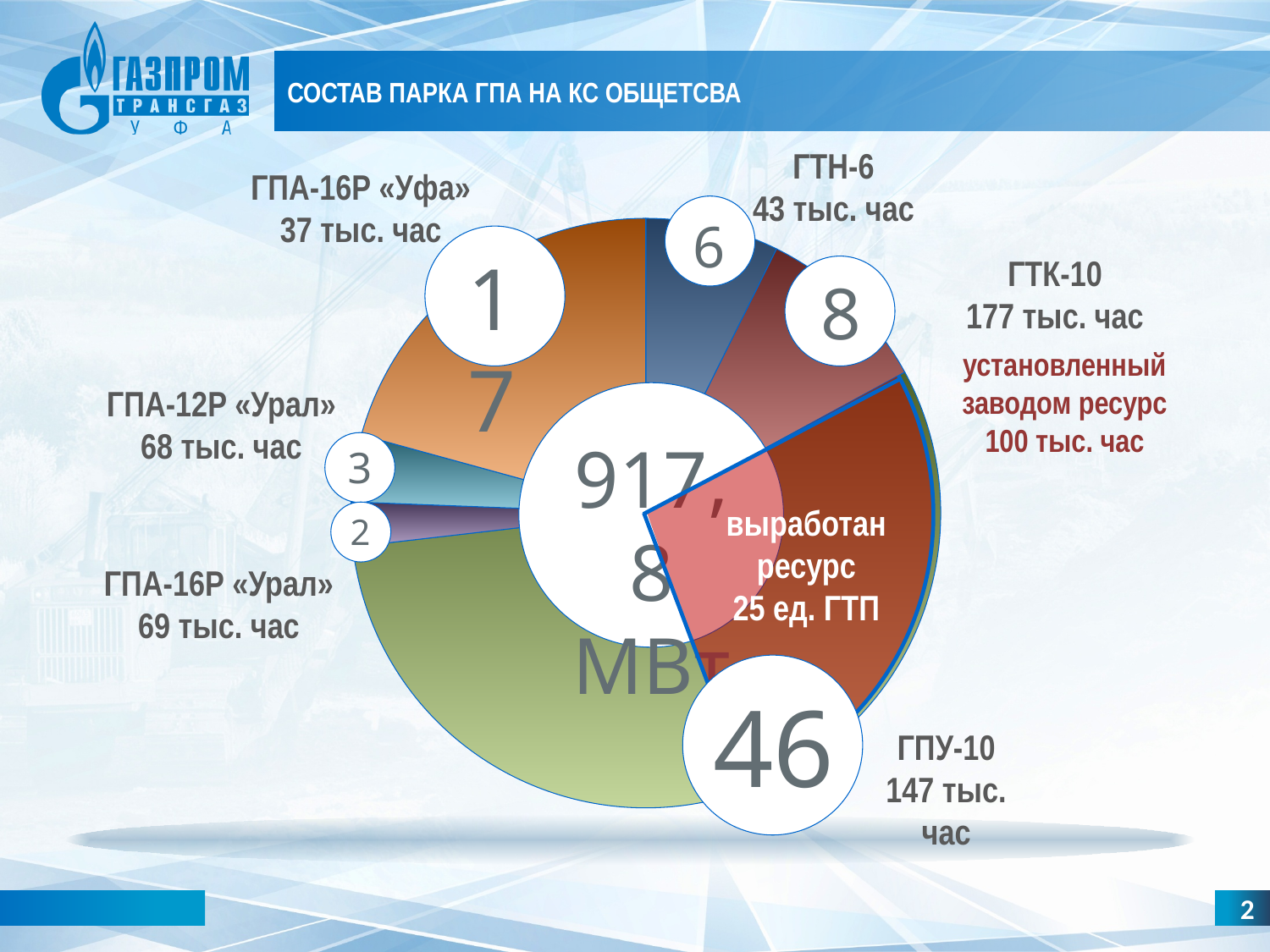
What is the title of the chart on the slide? СОСТАВ ПАРКА ГПА НА КС ОБЩЕТСВА What kind of chart is shown on the slide? pie chart How many ГТП units are marked as having exhausted their resource (выработан ресурс)? 25 ед. ГТП Which has more operating hours, ГПА-12Р «Урал» or ГПА-16Р «Урал»? ГПА-16Р «Урал» What operating hours figure is given for ГПА-16Р «Уфа»? 37 тыс. час Which category has the largest number of units in the pie chart? ГПУ-10 What operating hours figure is given for ГТК-10? 177 тыс. час How many units are shown for ГТК-10 in the pie chart? 8 What value is shown in the centre of the pie chart? 917,8 МВт How many units are shown for ГТН-6 in the pie chart? 6 How many units are shown for ГПУ-10 in the pie chart? 46 How many units are shown for ГПА-16Р «Уфа» in the pie chart? 17